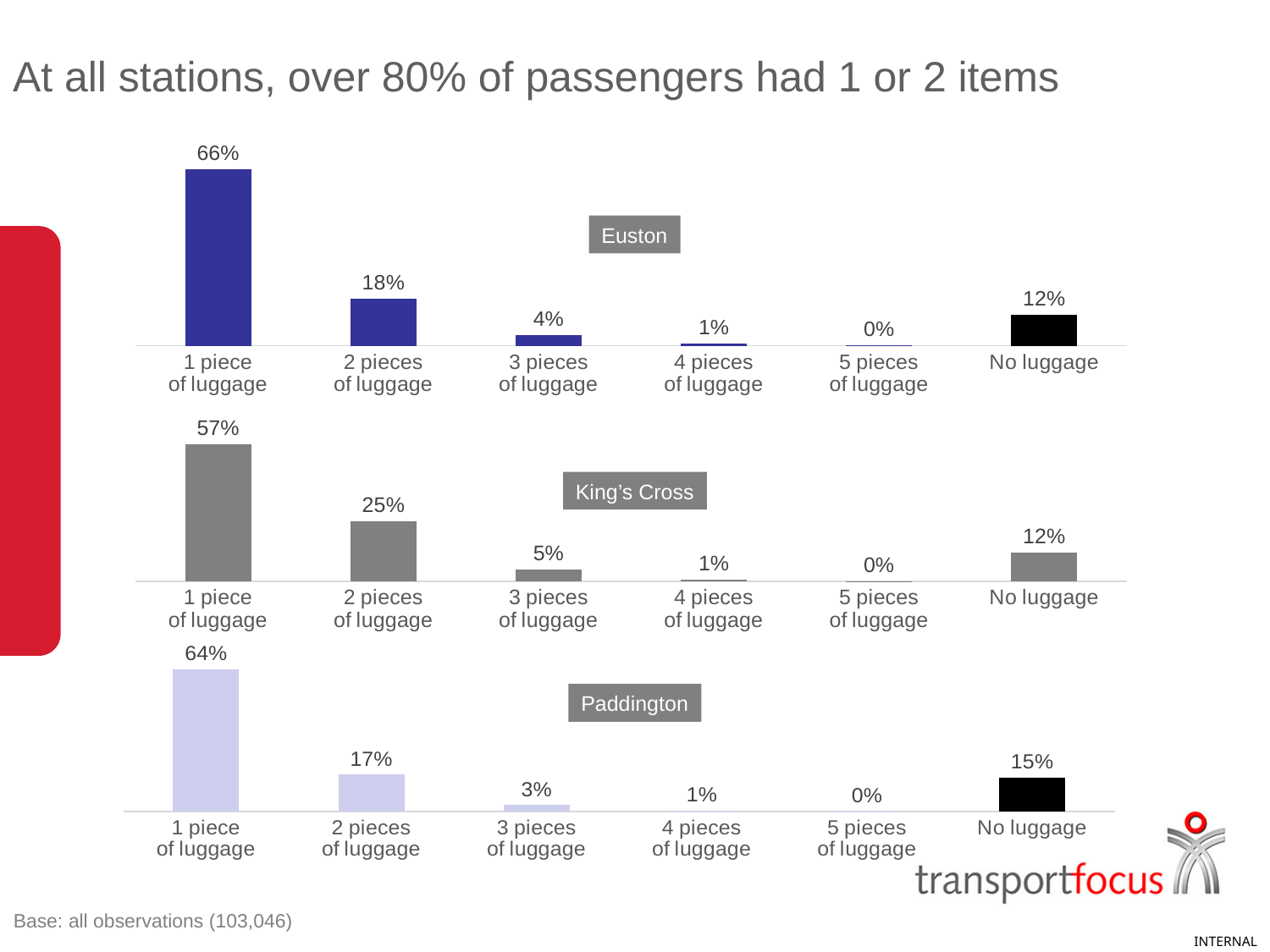
In the King's Cross chart, which category has the highest value? 1 piece of luggage How many charts are shown on the slide? 3 In the Euston chart, what is the difference between the values for 1 piece of luggage and 2 pieces of luggage? 48% What kind of chart is the Paddington chart? Bar chart In the Euston chart, what percentage of passengers had 1 piece of luggage? 66% In the Paddington chart, what percentage of passengers had no luggage? 15% In the King's Cross chart, do the values rise or fall from 1 piece of luggage to 5 pieces of luggage? Fall In the King's Cross chart, what percentage of passengers had 2 pieces of luggage? 25% In the Paddington chart, which category has the lowest value? 5 pieces of luggage In the Paddington chart, what is the difference between the values for 3 pieces of luggage and 4 pieces of luggage? 2% Which is larger: the value for 2 pieces of luggage at King's Cross or at Paddington? King's Cross How many categories are shown in the Euston chart? 6